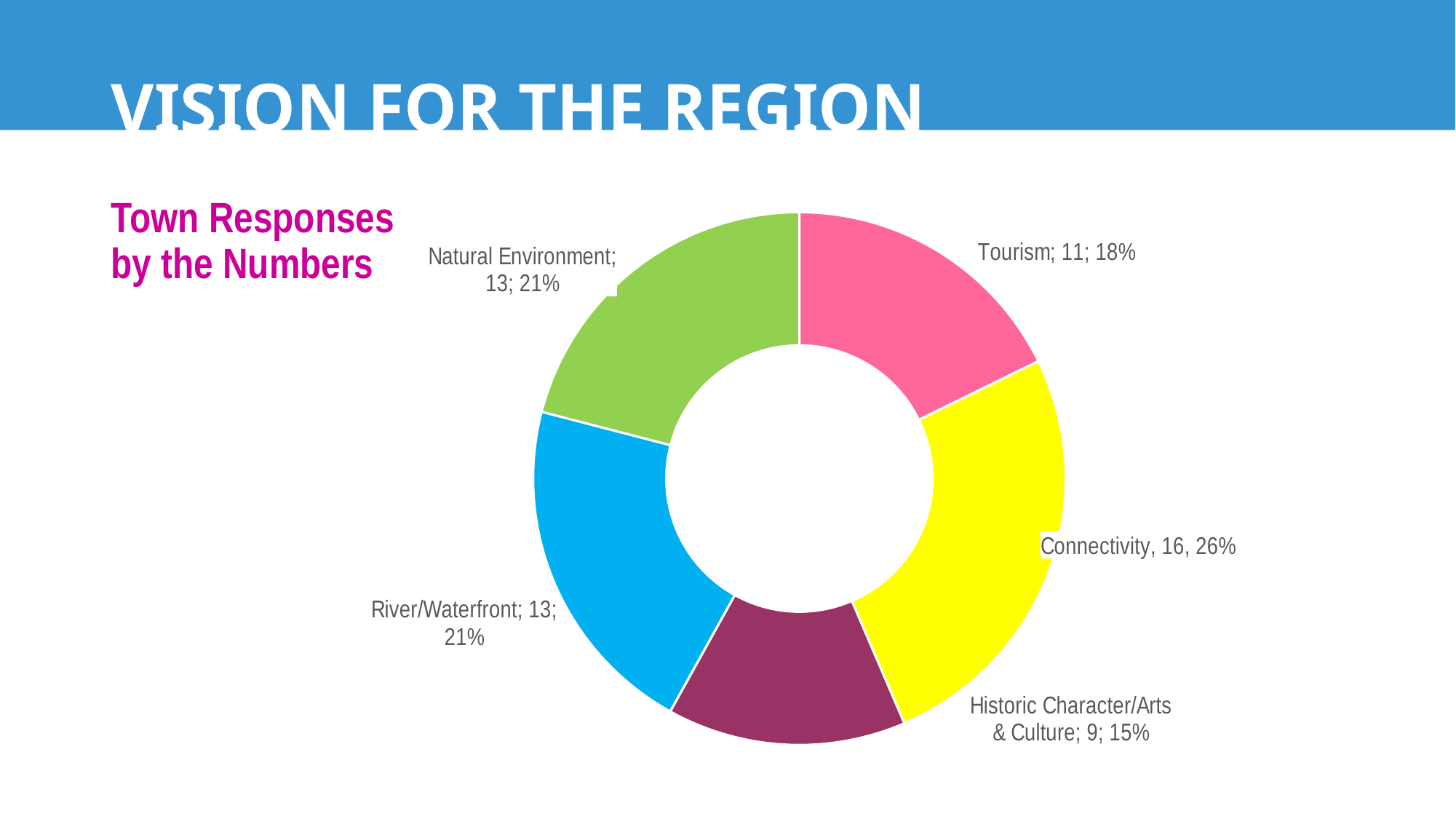
What colour is the Connectivity slice? Yellow Which is larger, the value for River/Waterfront or the value for Tourism? River/Waterfront What is the difference between the values for Connectivity and Tourism? 5 What share of the chart does Natural Environment represent? 21% Which category has the highest value? Connectivity What kind of chart is shown on the slide? Doughnut (pie) chart What is the value for Historic Character/Arts & Culture? 9 Which category has the lowest value? Historic Character/Arts & Culture What is the value for Tourism? 11 What is the value for Connectivity? 16 How many categories does the chart show? 5 What share of the chart does Connectivity represent? 26%